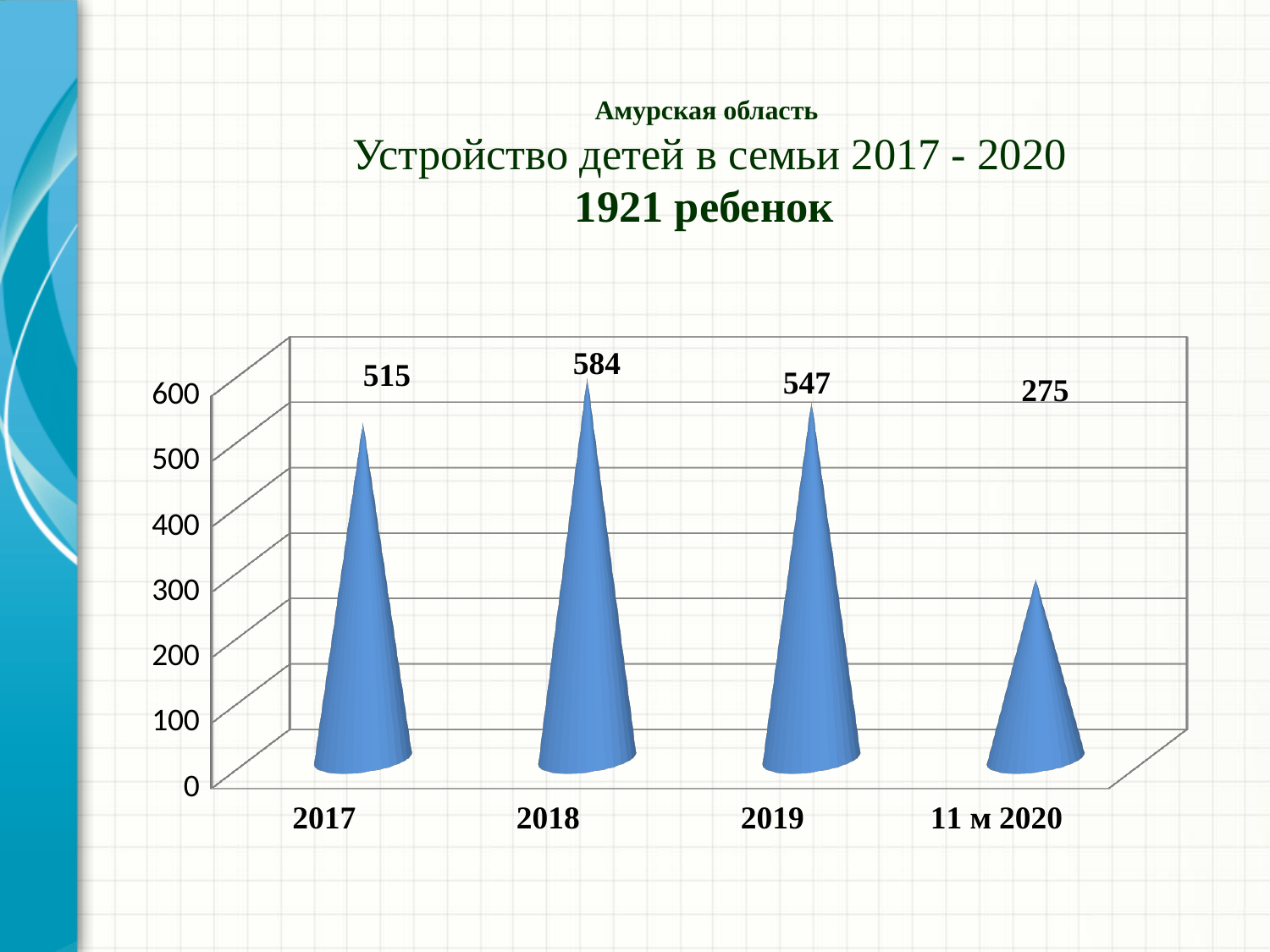
What total number of children is stated in the chart title? 1921 ребенок What is the difference between the values for 2018 and 2019? 37 What is the value for 2017? 515 Which is larger, the value for 2017 or the value for 2019? 2019 Which category has the highest value? 2018 What is the value for 2018? 584 What is the value for 11 м 2020? 275 What kind of chart is this? bar chart Which category has the lowest value? 11 м 2020 What is the difference between the values for 2017 and 11 м 2020? 240 How many categories are shown on the x axis? 4 What is the value for 2019? 547